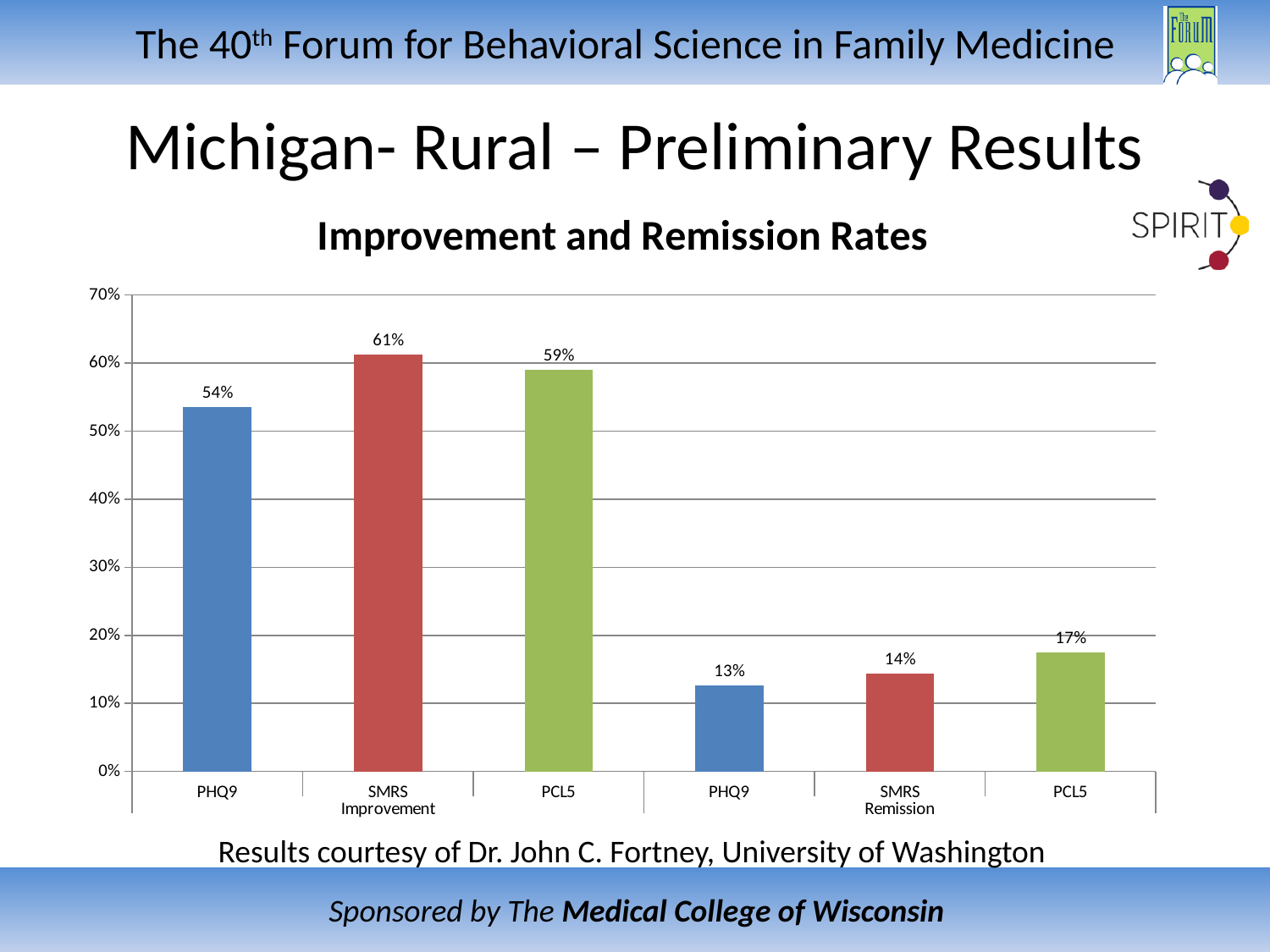
Which is larger, the PHQ9 improvement rate or the PCL5 improvement rate? PCL5 Is the PCL5 remission rate greater or less than 20%? less What is the PHQ9 improvement rate shown in the chart? 54% What is the difference between the PCL5 improvement rate and the PCL5 remission rate? 42% What type of chart is shown on the slide? bar chart What colour are the SMRS bars in the chart? red What is the SMRS remission rate shown in the chart? 14% Which measure has the lowest remission rate? PHQ9 How many bars are plotted in the chart? 6 What is the PCL5 improvement rate? 59% Which measure has the highest improvement rate? SMRS What is the title of the chart? Improvement and Remission Rates